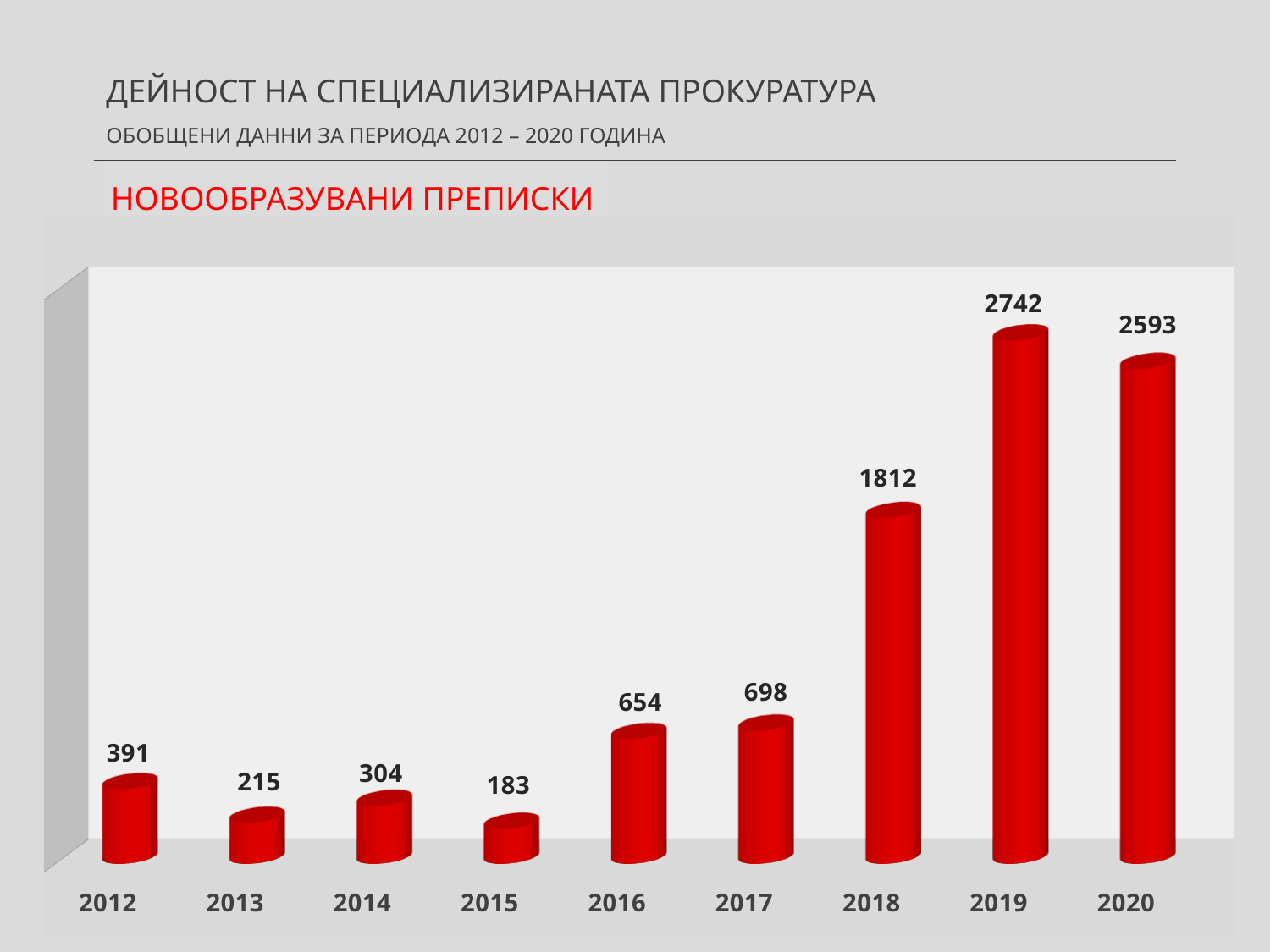
Which year has the highest value? 2019 What is the difference between the values for 2017 and 2016? 44 How many years are shown on the chart? 9 Which year has the lowest value? 2015 Which is larger, the value for 2013 or the value for 2014? 2014 What kind of chart is shown on the slide? bar chart What is the value for 2015? 183 What is the value for 2012? 391 What is the title of the chart? НОВООБРАЗУВАНИ ПРЕПИСКИ What is the value for 2018? 1812 What is the difference between the values for 2019 and 2020? 149 Do the values generally rise or fall from 2015 to 2019? rise